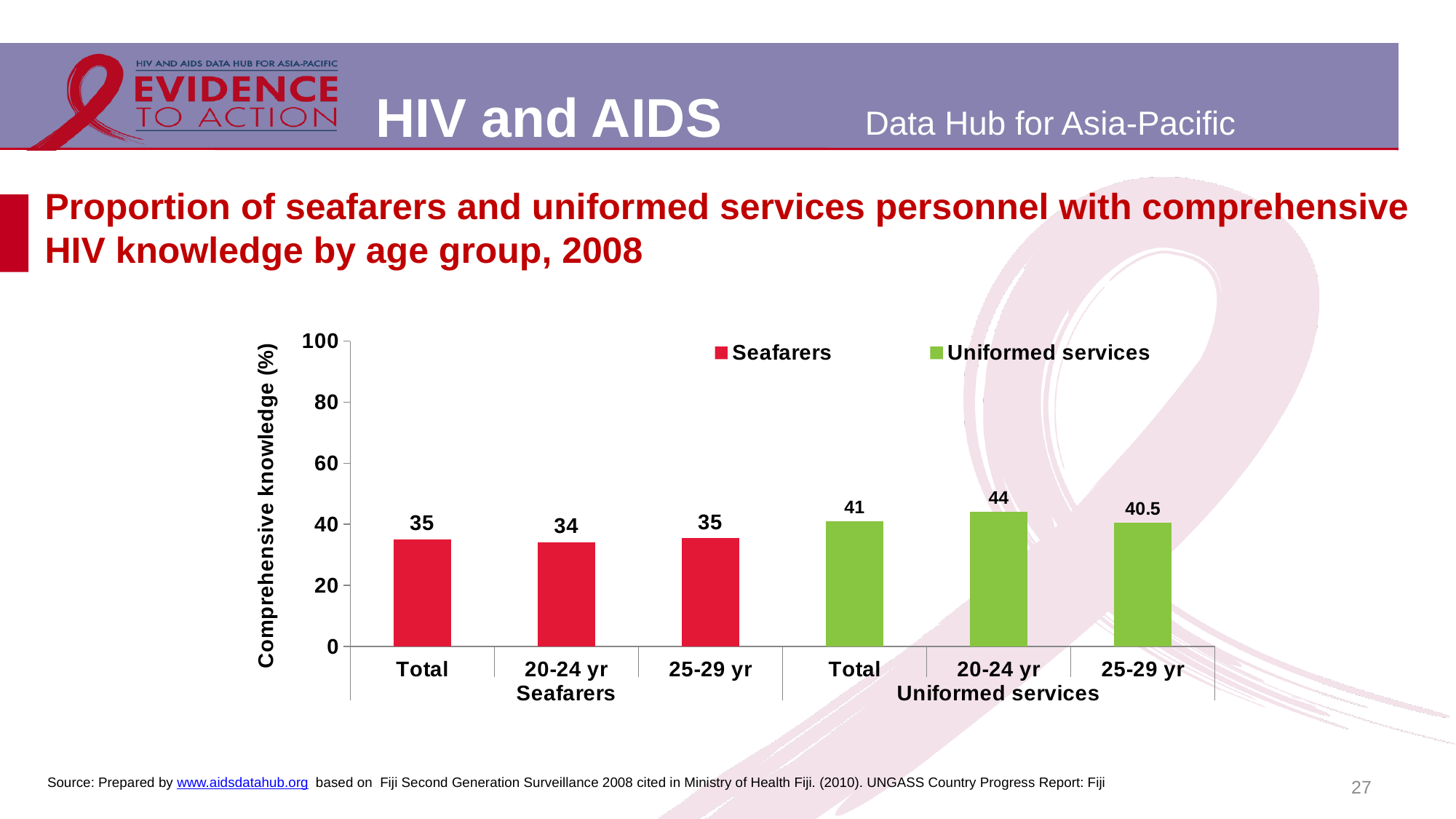
Which is larger: the 25-29 yr value for Seafarers or the 25-29 yr value for Uniformed services? Uniformed services What is the value for the 20-24 yr group among Seafarers? 34 How many series does the legend list? 2 What is the value for the Seafarers Total bar? 35 What is the difference between the Uniformed services Total and the Seafarers Total? 6 Which bar has the lowest value on the chart? Seafarers 20-24 yr How many bars are plotted on the chart? 6 What kind of chart is shown on the slide? Bar chart Which bar has the highest value on the chart? Uniformed services 20-24 yr What is the value for the 20-24 yr group among Uniformed services? 44 What is the label of the vertical axis? Comprehensive knowledge (%) What is the value for the 25-29 yr group among Uniformed services? 40.5